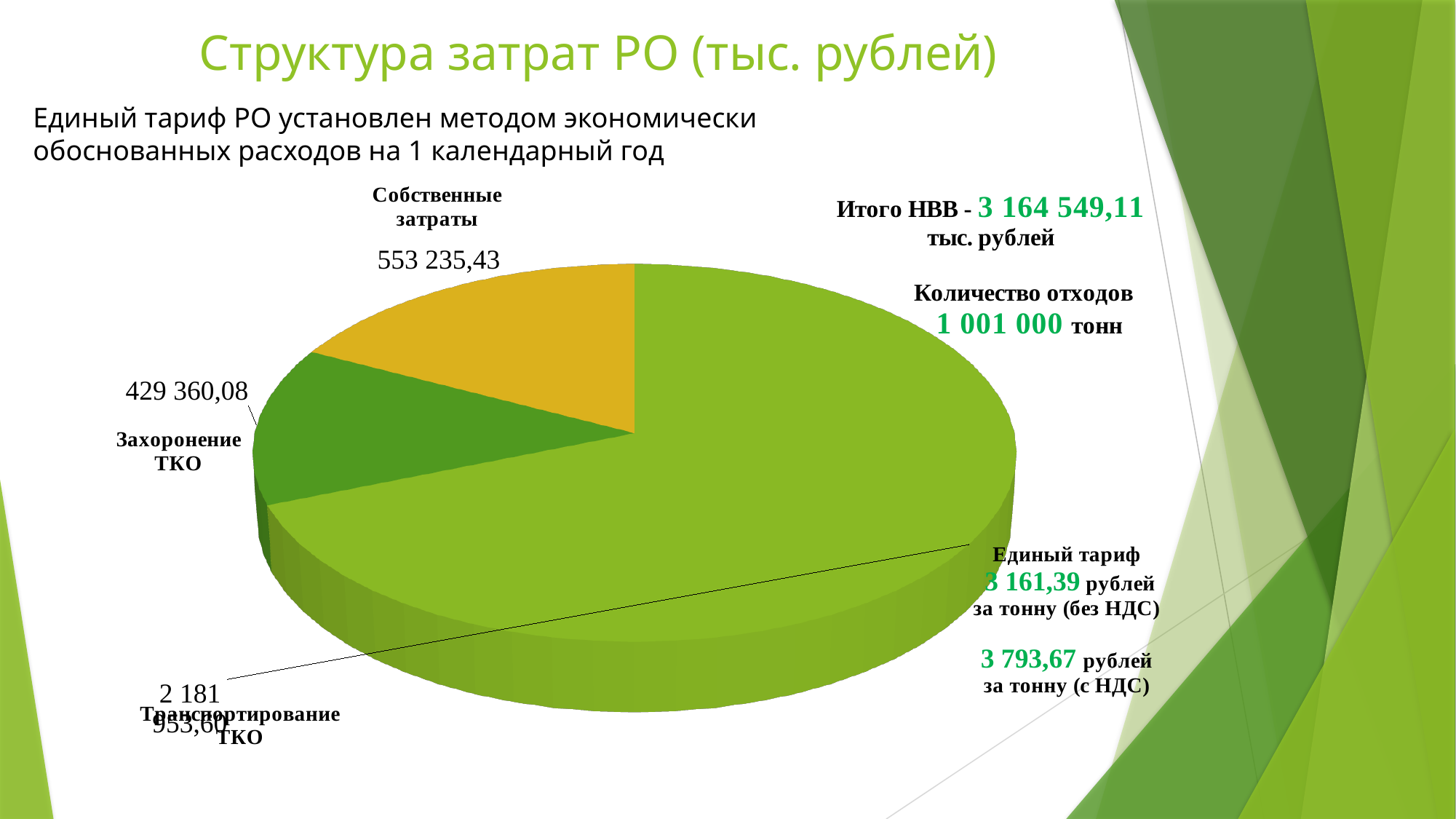
Which is larger: Собственные затраты or Захоронение ТКО? Собственные затраты What is the title of the slide containing the chart? Структура затрат РО (тыс. рублей) What is the total of all slices in the pie chart (Итого НВВ)? 3 164 549,11 What is the value for Собственные затраты on the pie chart? 553 235,43 What kind of chart is shown on the slide? Pie chart Which category has the largest slice of the pie chart? Транспортирование ТКО How many slices does the pie chart have? 3 What colour is the Собственные затраты slice of the pie chart? Yellow Which category has the smallest slice of the pie chart? Захоронение ТКО What is the value for Захоронение ТКО on the pie chart? 429 360,08 What is the value for Транспортирование ТКО on the pie chart? 2 181 953,60 What is the difference between the values for Собственные затраты and Захоронение ТКО? 123 875,35